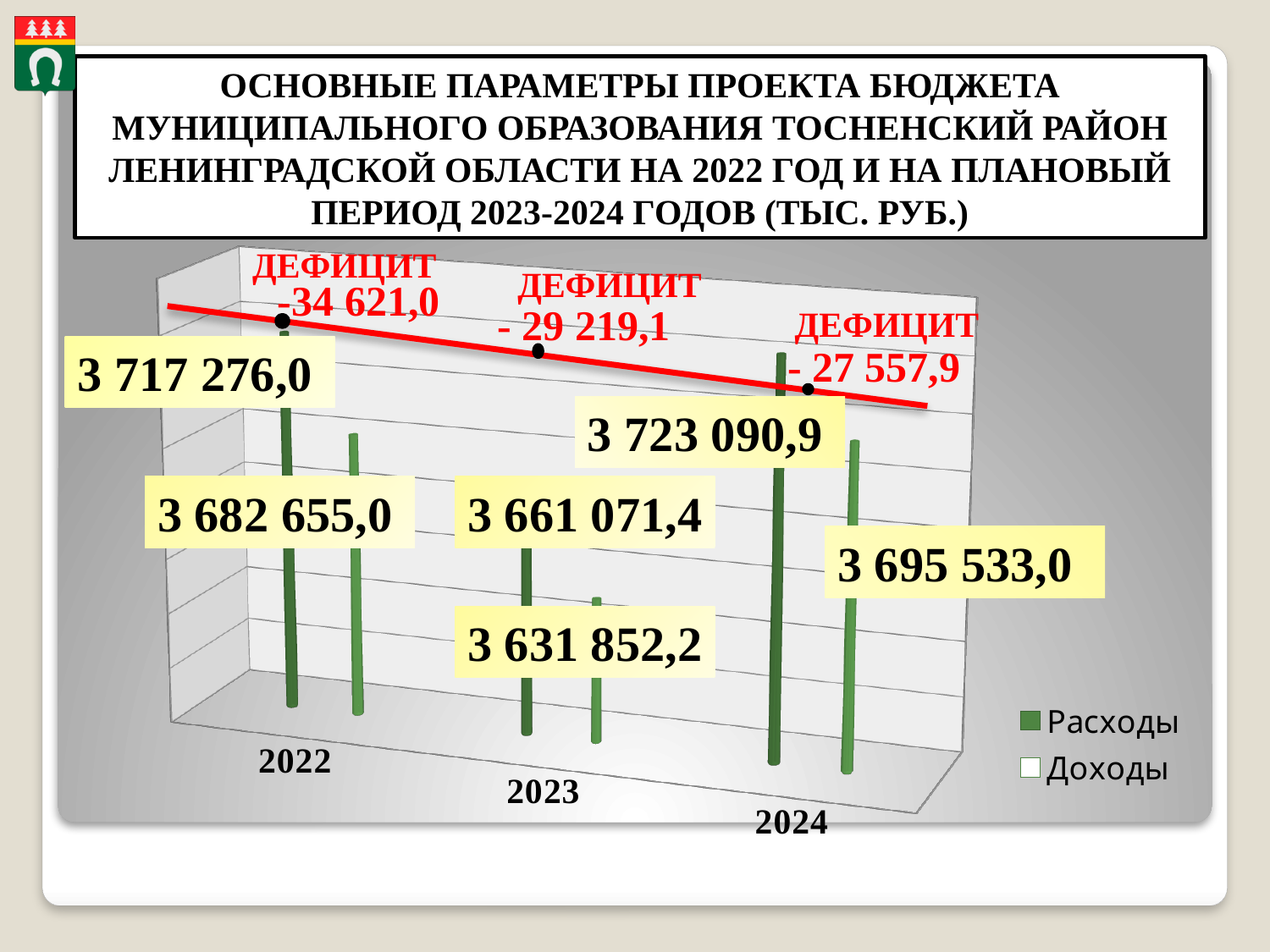
In which year is the value of Доходы the lowest? 2023 What is the value of Расходы for 2022? 3 717 276,0 Which is larger in 2022, Расходы or Доходы? Расходы What type of chart is shown on the slide? bar chart How many years are shown on the x axis? 3 What is the value of Доходы for 2024? 3 695 533,0 What is the difference between Расходы and Доходы in 2024? 27 557,9 How many series does the legend list? 2 What is the value of Доходы for 2023? 3 631 852,2 What are the two series named in the legend? Расходы and Доходы What deficit (ДЕФИЦИТ) is shown for 2023? - 29 219,1 In which year is the value of Расходы the highest? 2024